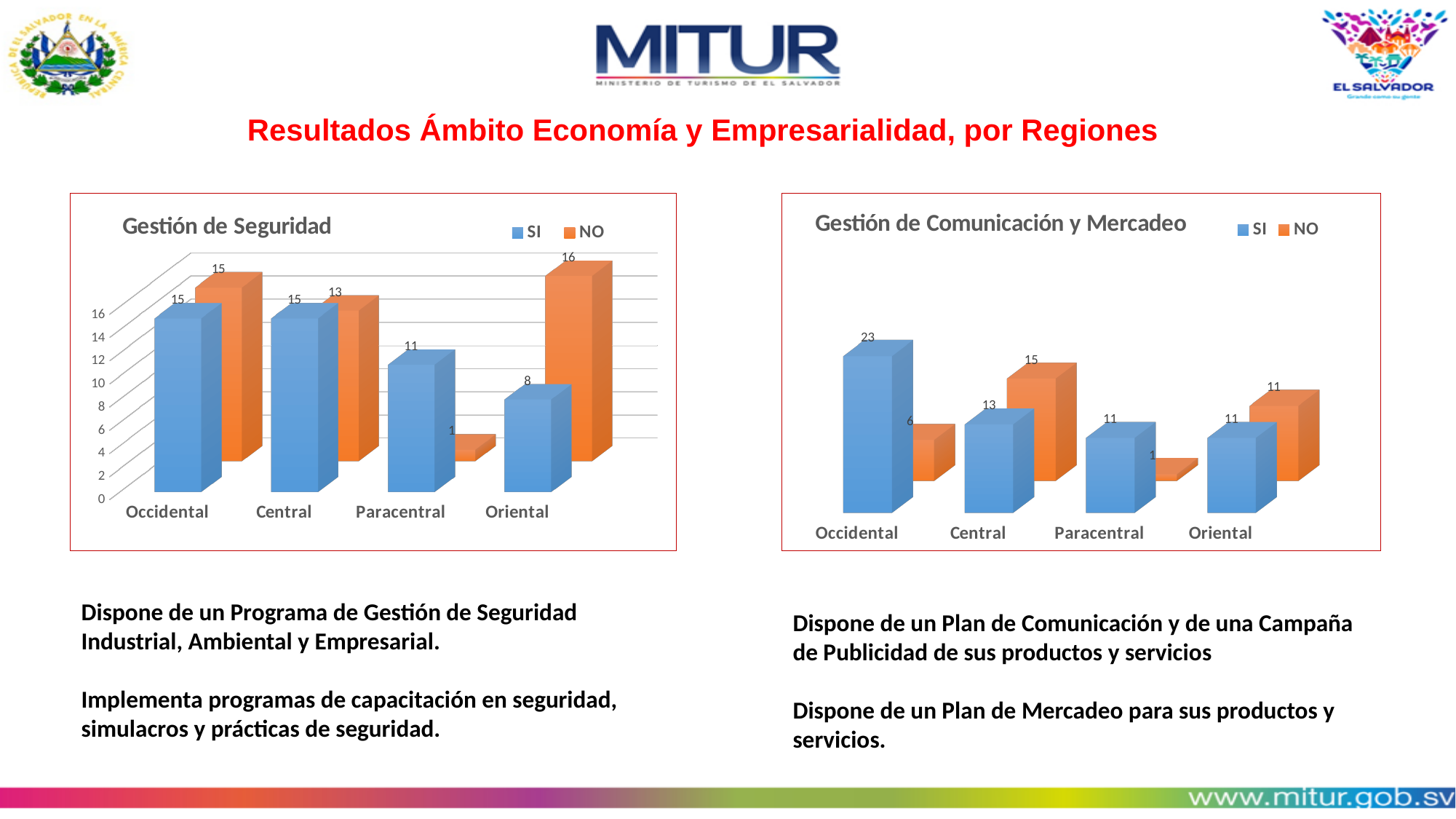
In the 'Gestión de Seguridad' chart, which region has the lowest NO value? Paracentral In the 'Gestión de Comunicación y Mercadeo' chart, which region has the highest SI value? Occidental In the 'Gestión de Comunicación y Mercadeo' chart, what is the NO value for Central? 15 In the 'Gestión de Seguridad' chart, what is the NO value for Oriental? 16 In the 'Gestión de Seguridad' chart, is the SI value for Central larger or smaller than the NO value for Central? larger In the 'Gestión de Comunicación y Mercadeo' chart, how many regions are shown on the x axis? 4 What type of chart is the 'Gestión de Comunicación y Mercadeo' chart? Bar chart In the 'Gestión de Seguridad' chart, how many series does the legend list? 2 In the 'Gestión de Seguridad' chart, what is the difference between the NO and SI values for Oriental? 8 In the 'Gestión de Comunicación y Mercadeo' chart, what is the SI value for Occidental? 23 In the 'Gestión de Seguridad' chart, what is the SI value for Paracentral? 11 In the 'Gestión de Comunicación y Mercadeo' chart, what is the difference between the SI and NO values for Occidental? 17